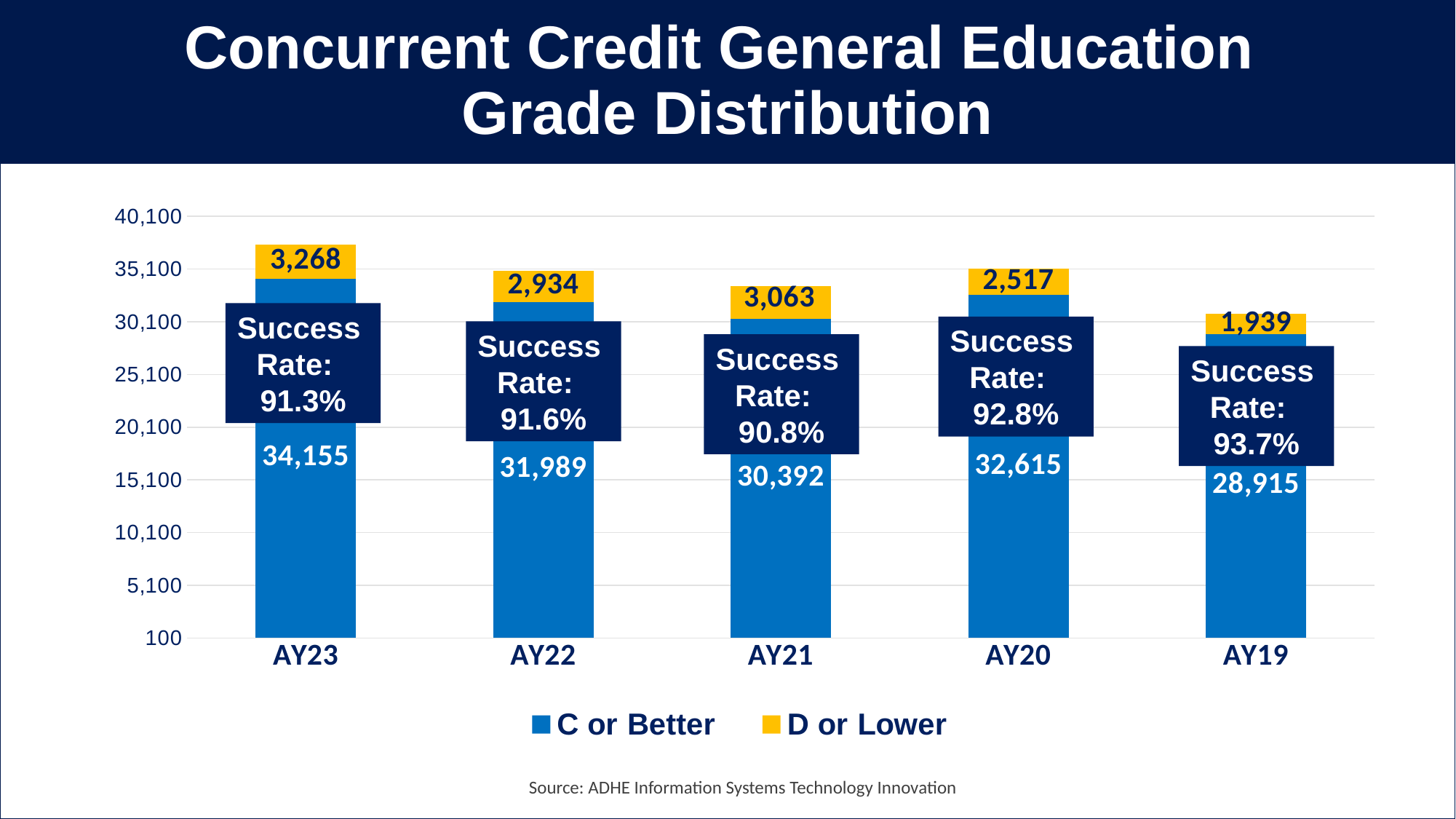
What kind of chart is shown on the slide? Stacked bar chart What is the difference between the C or Better values for AY23 and AY19? 5,240 How many series does the legend list? 2 Which is larger, the D or Lower value for AY22 or for AY21? AY21 Which colour represents the D or Lower series? Yellow Which academic year has the lowest D or Lower value? AY19 What is the value for D or Lower in AY20? 2,517 What is the total of the stacked bar for AY22? 34,923 What is the success rate shown for AY19? 93.7% What is the value for C or Better in AY23? 34,155 Which academic year has the highest C or Better value? AY23 How many academic years are shown on the x axis? 5